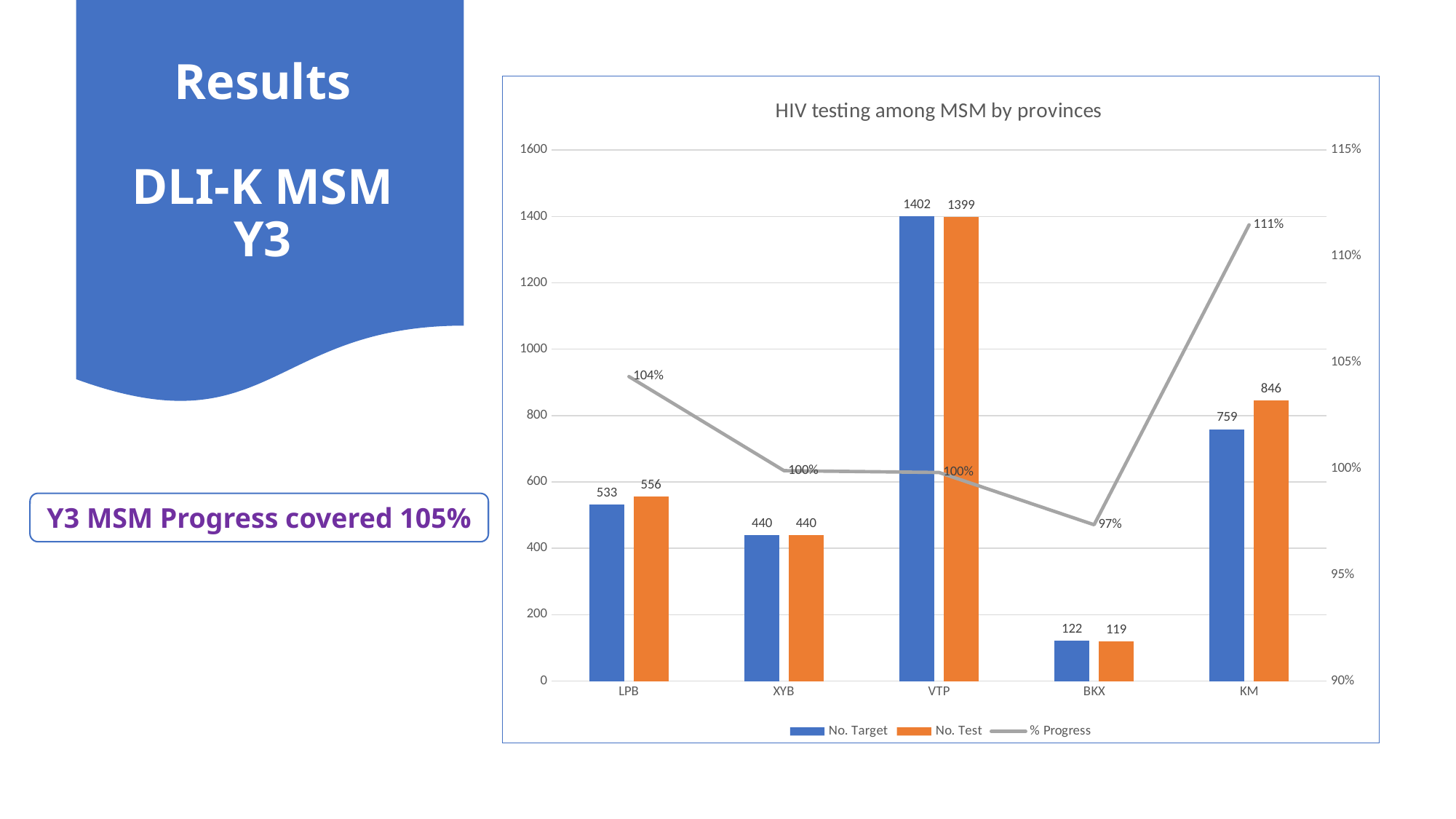
What is the No. Test value for KM? 846 What is the title of the chart? HIV testing among MSM by provinces How many series does the legend list? 3 Which province has the highest % Progress? KM What is the No. Target value for LPB? 533 Which province has the highest No. Test value? VTP Which is larger for LPB, No. Target or No. Test? No. Test Is the No. Target value for VTP greater or less than 1200? greater Which province has the lowest No. Target value? BKX What is the % Progress value for BKX? 97% How many provinces are shown on the x axis? 5 What is the difference between No. Test and No. Target for KM? 87